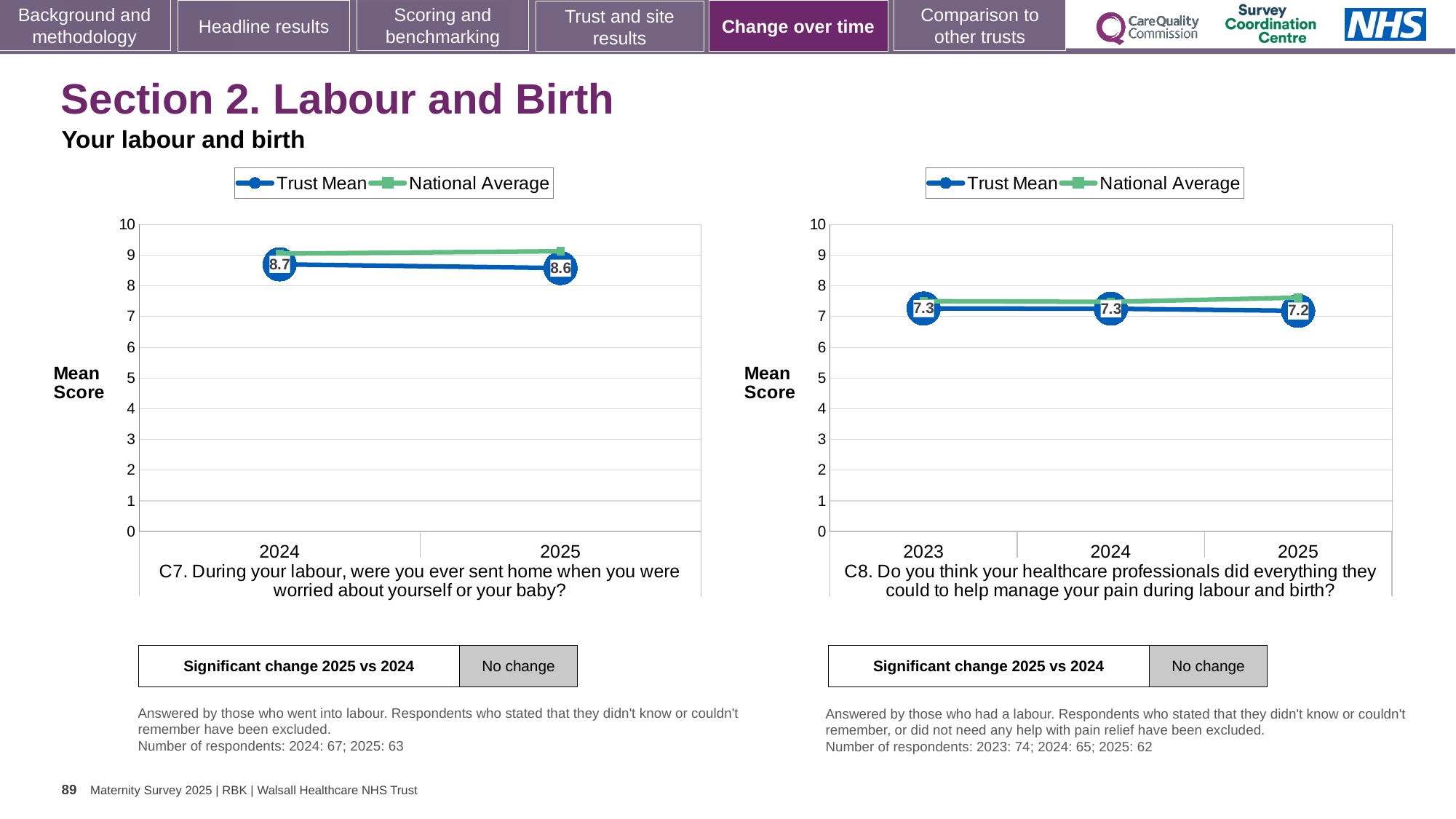
What kind of chart is the C8 chart (right)? Line chart On the C8 chart (right), is the National Average for 2025 greater or less than 7? greater How many years are plotted on the C8 chart (right)? 3 What is the label on the vertical axis of the C7 chart (left)? Mean Score On the C7 chart (left), by how much did the Trust Mean change from 2024 to 2025? 0.1 How many series does the legend of the C7 chart (left) list? 2 On the C7 chart (left), what is the Trust Mean for 2024? 8.7 On the C7 chart (left), what is the Trust Mean for 2025? 8.6 On the C7 chart (left), does the Trust Mean rise or fall from 2024 to 2025? Fall On the C8 chart (right), what is the Trust Mean for 2023? 7.3 On the C8 chart (right), what is the Trust Mean for 2025? 7.2 On the C8 chart (right), what is the difference between the Trust Mean in 2023 and in 2025? 0.1